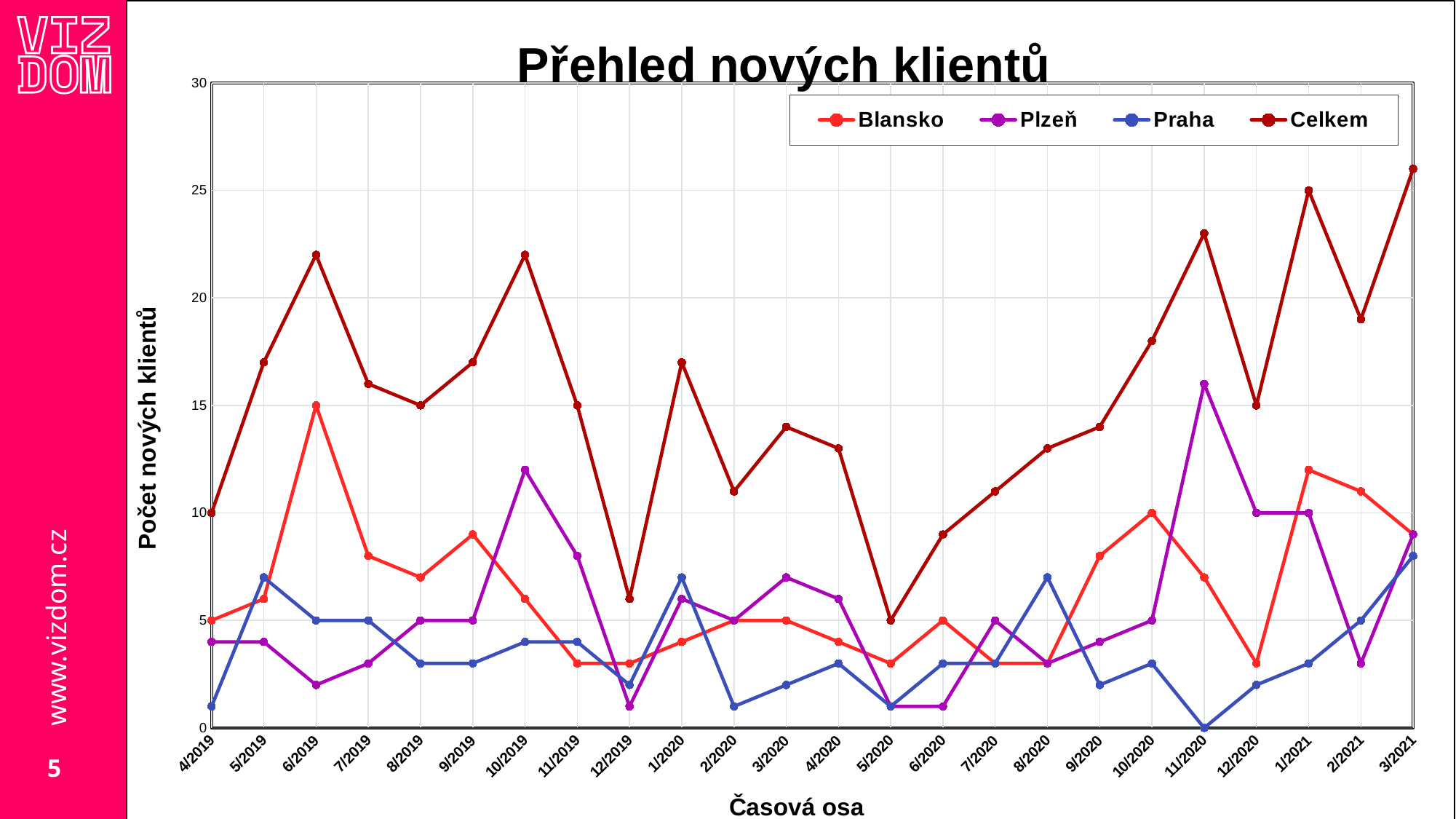
What is the value of Praha in 11/2020? 0 What is the value of Celkem in 4/2019? 10 What is the value of Blansko in 6/2019? 15 Which series has the highest values across the whole chart? Celkem What is the value of Celkem in 1/2021? 25 How many series does the legend list? 4 What kind of chart is shown on the slide? line chart Is the value for Celkem in 6/2019 greater or less than 20? greater How many time points are shown on the x axis? 24 In 11/2020, which is larger: Plzeň or Blansko? Plzeň What is the difference between the Celkem value in 1/2021 and the Celkem value in 4/2019? 15 What is the title of the chart? Přehled nových klientů